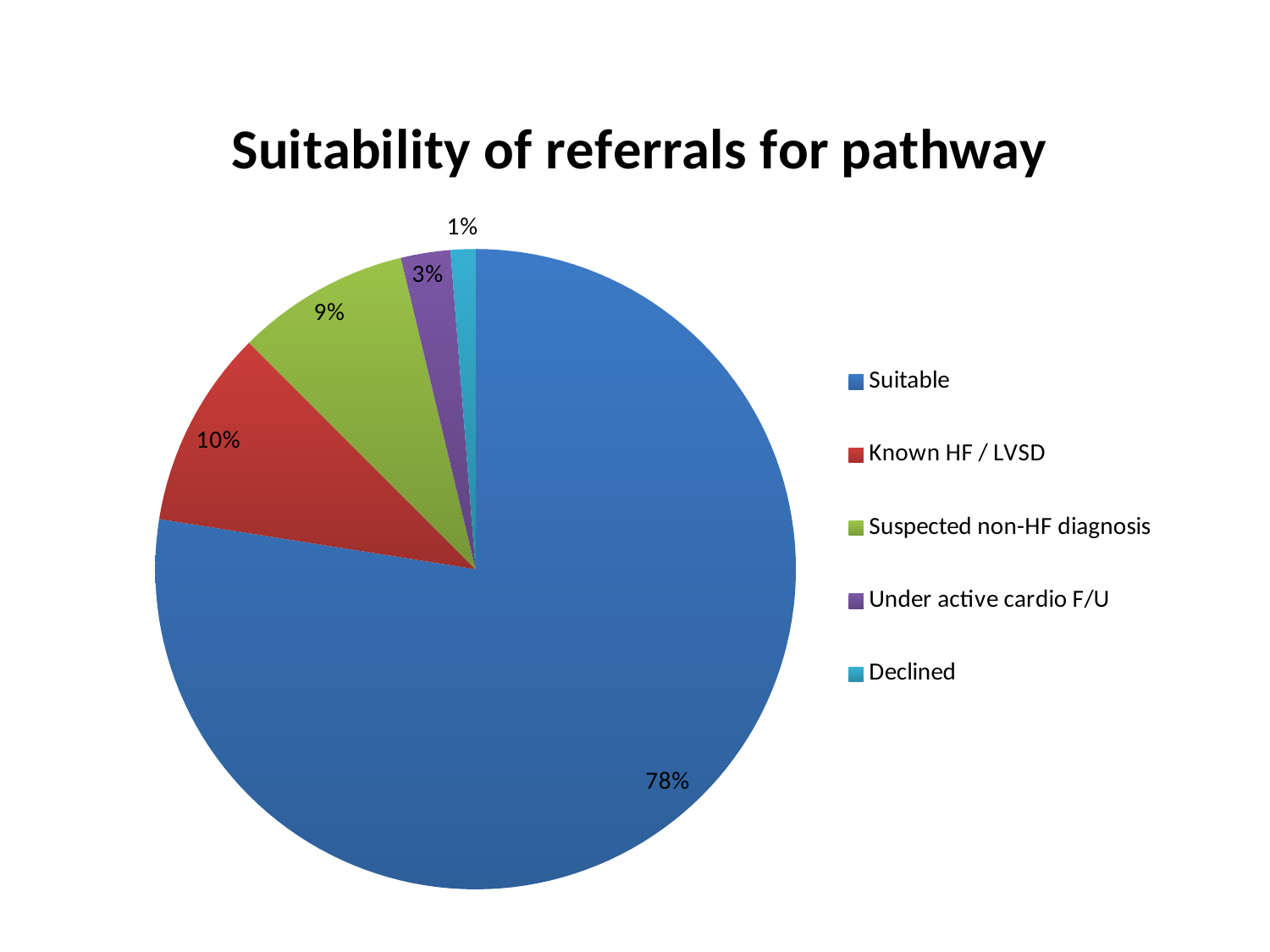
What is the title of the chart? Suitability of referrals for pathway Which category has the largest share of the pie? Suitable What percentage of referrals had a Suspected non-HF diagnosis? 9% What percentage of referrals were Suitable? 78% What type of chart is shown on the slide? Pie chart Which category has the smallest share of the pie? Declined Which is larger, the share for Suspected non-HF diagnosis or the share for Under active cardio F/U? Suspected non-HF diagnosis What percentage of referrals were Under active cardio F/U? 3% What percentage of referrals were Known HF / LVSD? 10% How many categories does the legend list? 5 What percentage of referrals were Declined? 1% What is the difference in percentage points between Suitable and Known HF / LVSD? 68